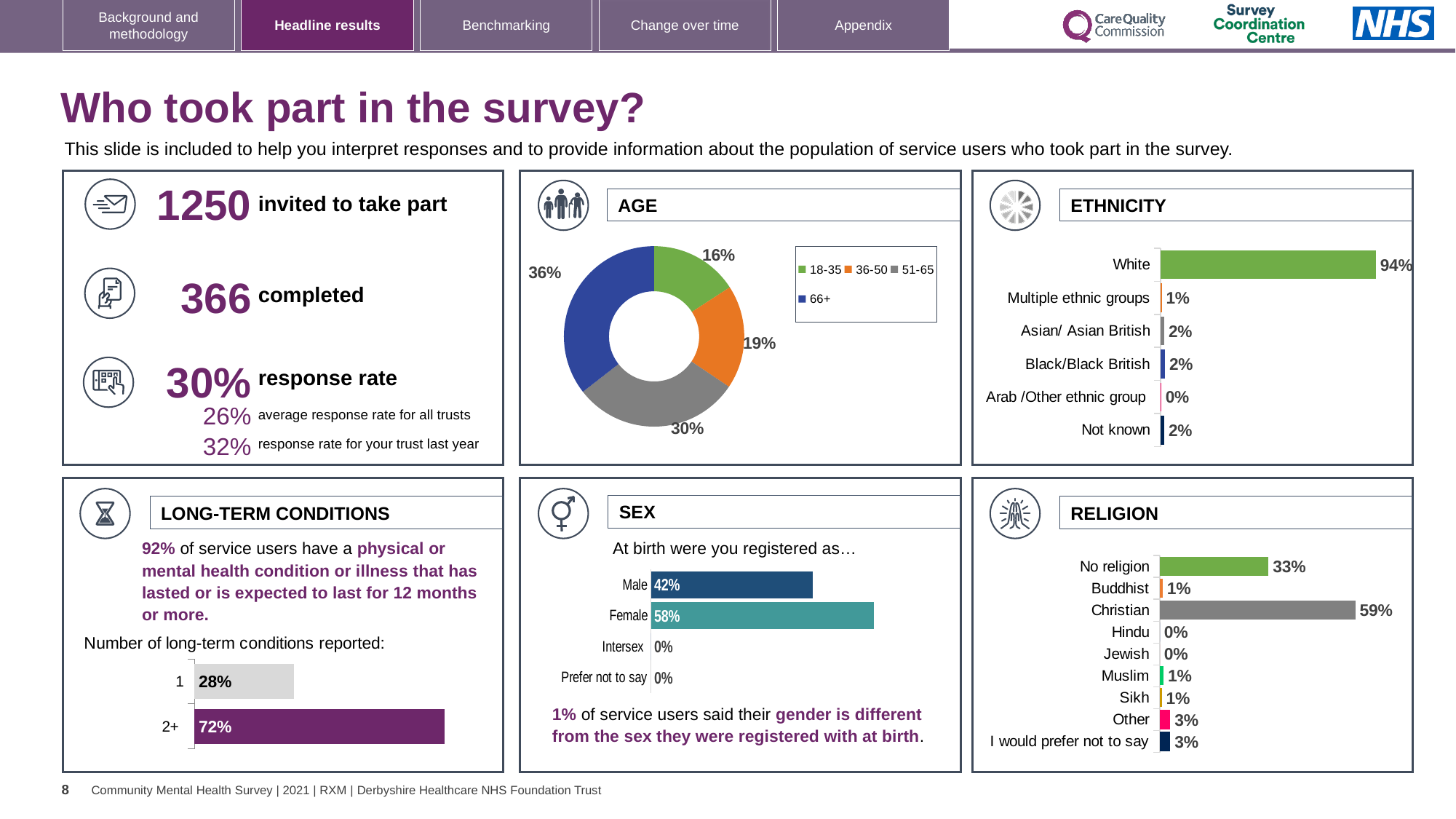
In the SEX chart, which is larger, Male or Female? Female In the RELIGION chart, which category has the highest value? Christian In the RELIGION chart, what is the difference between Christian and No religion? 26% In the ETHNICITY chart, how many ethnic categories are shown? 6 In the LONG-TERM CONDITIONS chart, what percentage reported 2+ conditions? 72% In the SEX chart, what is the value for Female? 58% In the AGE chart, which age group has the smallest share? 18-35 In the ETHNICITY chart, what is the difference between White and Asian/ Asian British? 92% In the AGE chart, what percentage of respondents were aged 66+? 36% What kind of chart is the AGE chart? Donut (pie) chart How many age groups does the legend of the AGE chart list? 4 In the ETHNICITY chart, what is the value for White? 94%